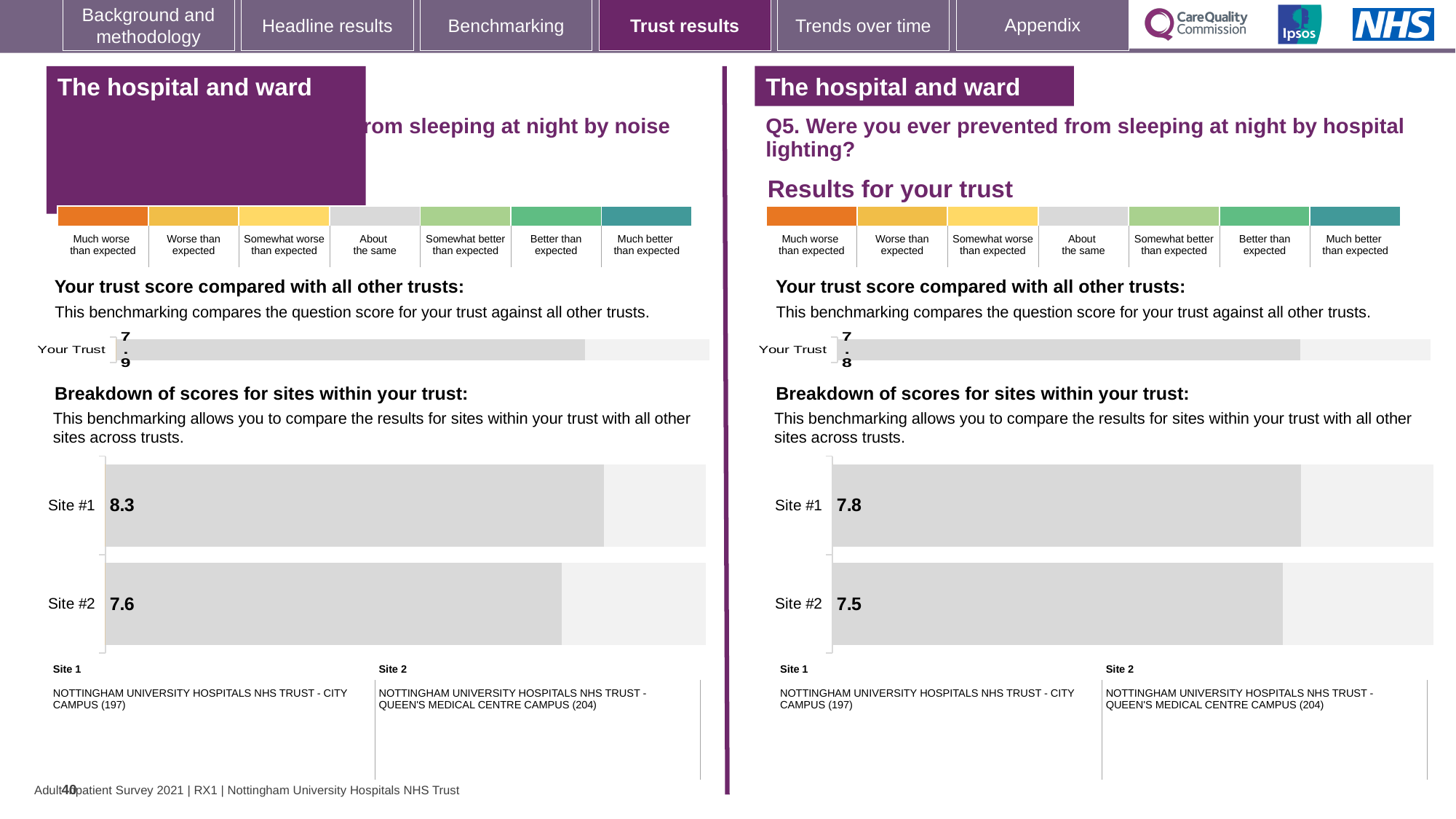
How many sites are shown in the Q5 hospital lighting site breakdown chart on the right? 2 On the left-hand side of the slide, what is the score for Site #2 in the breakdown of scores for sites within your trust? 7.6 On the left-hand side of the slide, which site has the higher score in the site breakdown chart? Site #1 In the Q5 hospital lighting site breakdown chart on the right, which site has the lower score? Site #2 On the left-hand side of the slide, what is the score for Site #1 in the breakdown of scores for sites within your trust? 8.3 In the Q5 hospital lighting section on the right, what is the score for Site #2? 7.5 On the left-hand side of the slide, what is the 'Your Trust' score in the trust score comparison chart? 7.9 On the left-hand side of the slide, what is the difference between the Site #1 and Site #2 scores in the site breakdown chart? 0.7 In the Q5 hospital lighting section on the right, what is the 'Your Trust' score in the trust score comparison chart? 7.8 In the Q5 hospital lighting site breakdown chart on the right, what is the difference between the Site #1 and Site #2 scores? 0.3 What type of chart is used for the site breakdown on the left-hand side of the slide? Bar chart In the Q5 hospital lighting section on the right, what is the score for Site #1? 7.8